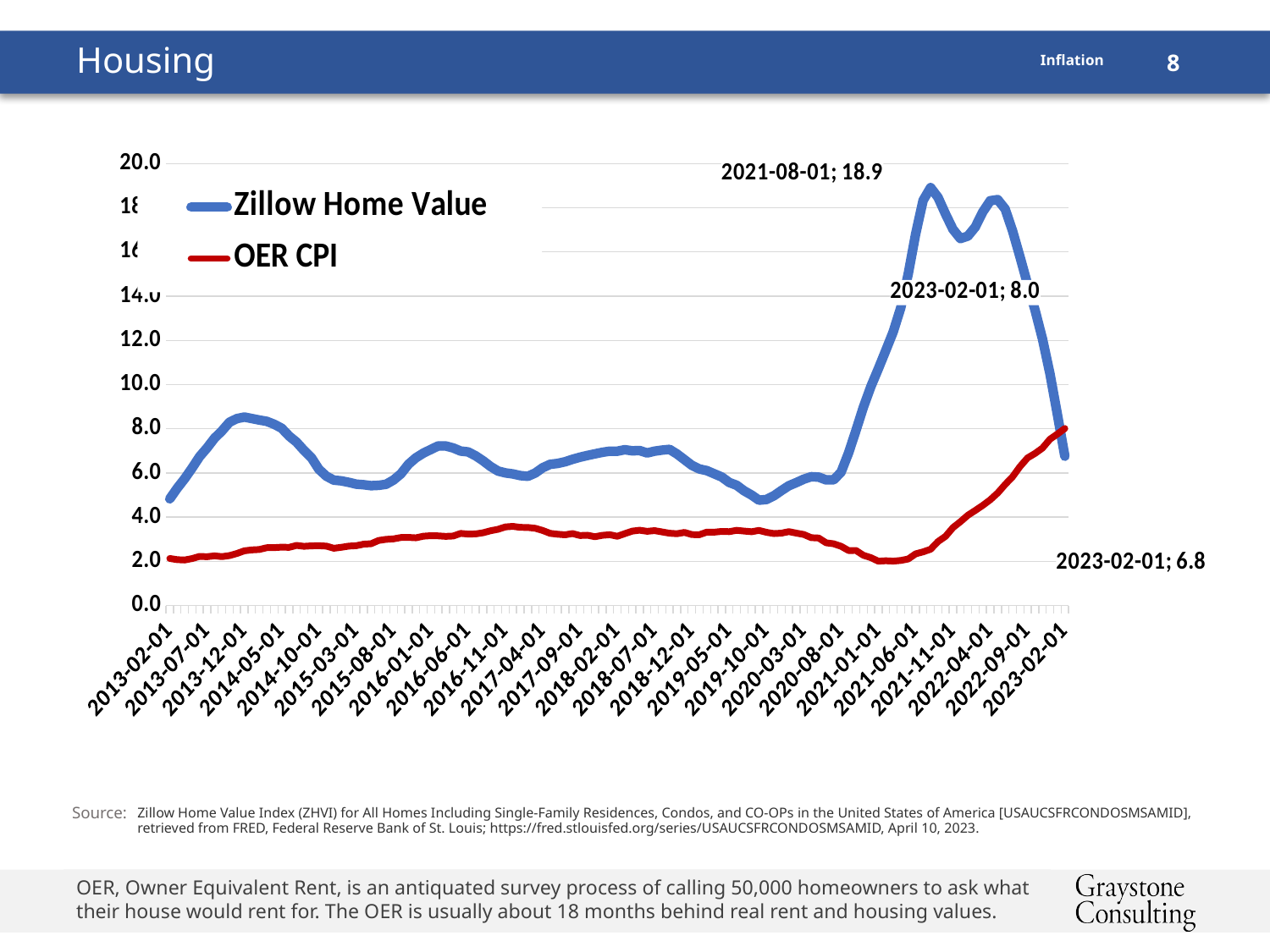
What is the labelled value of Zillow Home Value on 2023-02-01? 6.8 Which series reaches the highest value anywhere on the chart? Zillow Home Value What is the difference between the OER CPI value (8.0) and the Zillow Home Value (6.8) on 2023-02-01? 1.2 On what date does the Zillow Home Value series reach its labelled peak of 18.9? 2021-08-01 What kind of chart is shown on the slide? line chart Is the OER CPI value at 2021-01-01 greater or less than 4.0? less What is the labelled value of OER CPI on 2023-02-01? 8.0 What is the peak value of the Zillow Home Value series, as labelled on the chart? 18.9 How many series does the legend list? 2 Is the Zillow Home Value at 2013-02-01 greater or less than 6.0? less On 2023-02-01, which series has the higher value, Zillow Home Value or OER CPI? OER CPI What colour is the OER CPI line? red